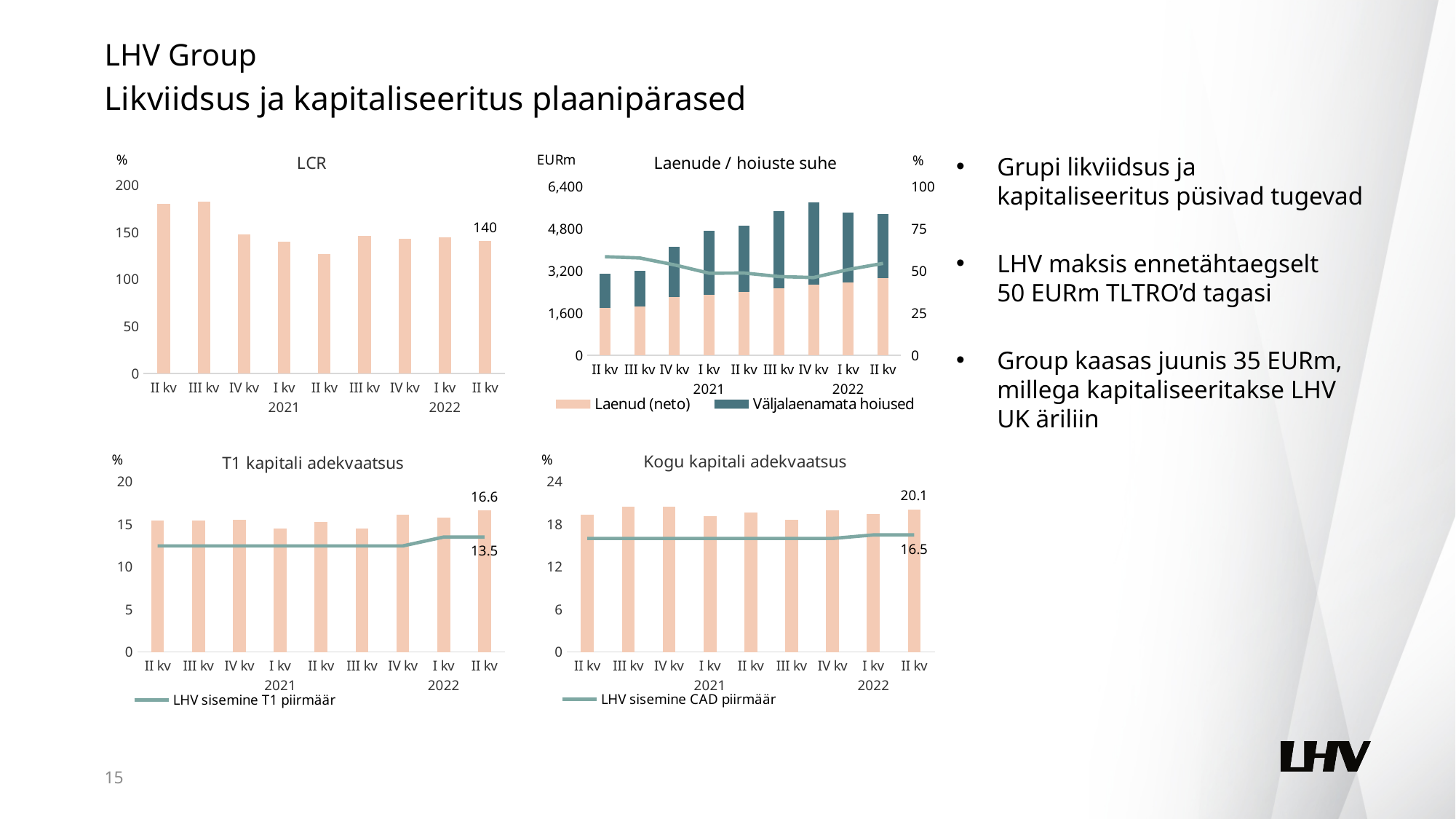
In the Kogu kapitali adekvaatsus chart, which is larger at II kv 2022: the bar value or the LHV sisemine CAD piirmäär line value? the bar value (20.1) How many quarters are plotted in the LCR chart? 9 What kind of chart is the LCR chart? bar chart In the LCR chart, is the value for II kv 2020 greater or less than 150? greater In the T1 kapitali adekvaatsus chart, what is the value of the LHV sisemine T1 piirmäär line at II kv 2022? 13.5 How many series does the legend of the Laenude / hoiuste suhe chart list? 2 In the Kogu kapitali adekvaatsus chart, what is the difference between the II kv 2022 bar value and the LHV sisemine CAD piirmäär value at II kv 2022? 3.6 In the T1 kapitali adekvaatsus chart, what is the value of the bar for II kv 2022? 16.6 What are the legend entries of the Laenude / hoiuste suhe chart? Laenud (neto), Väljalaenamata hoiused In the LCR chart, what is the value for II kv 2022? 140 In the LCR chart, is the value for II kv 2021 greater or less than 150? less In the LCR chart, which quarter has the lowest value? II kv 2021